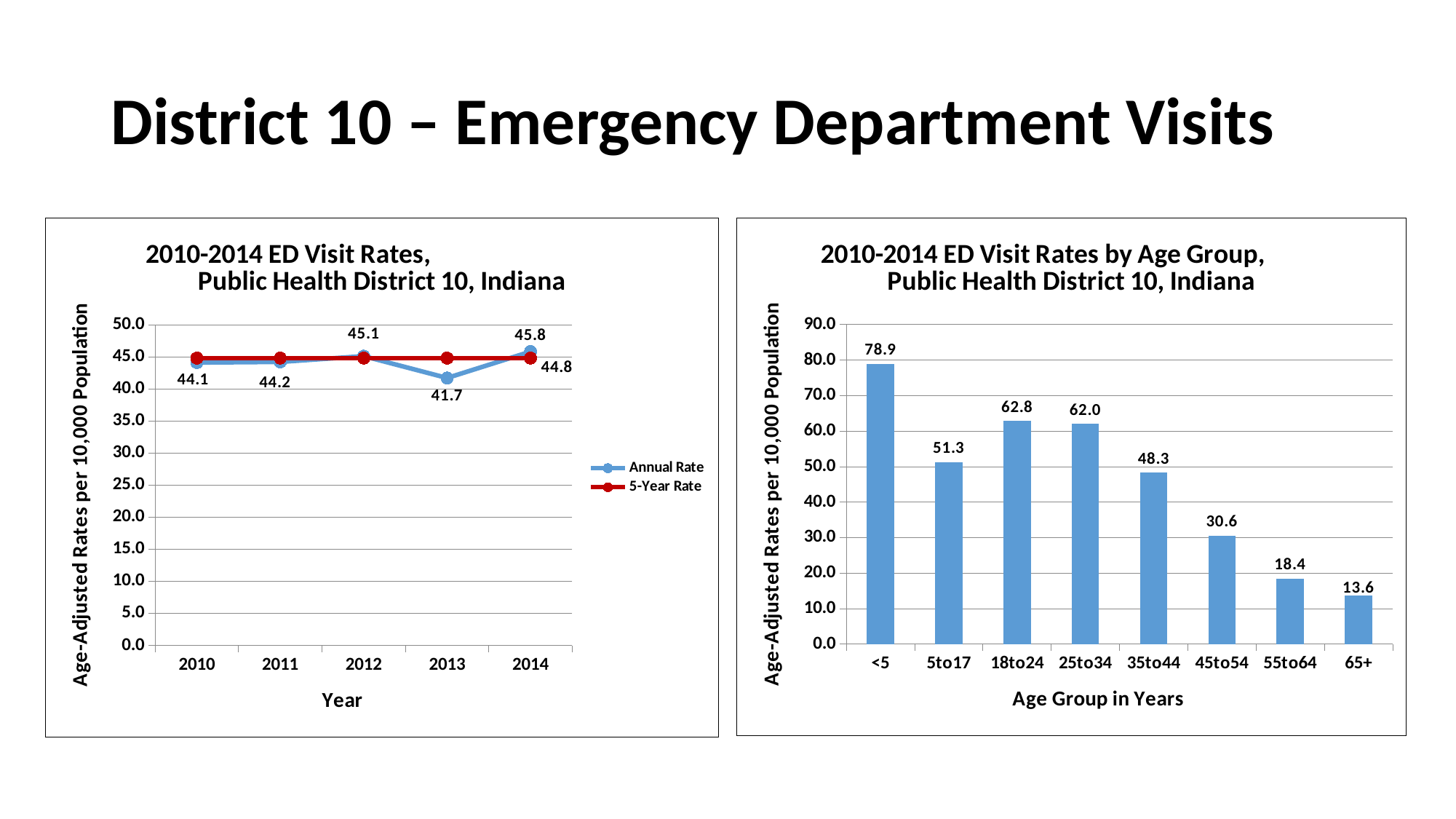
In the right chart (ED Visit Rates by Age Group), how many age groups are shown? 8 In the left chart (2010-2014 ED Visit Rates), what is the Annual Rate for 2013? 41.7 In the left chart (2010-2014 ED Visit Rates), what type of chart is shown? Line chart In the left chart (2010-2014 ED Visit Rates), which year has the highest Annual Rate? 2014 In the left chart (2010-2014 ED Visit Rates), what is the 5-Year Rate? 44.8 In the right chart (ED Visit Rates by Age Group), which is larger: the rate for 18to24 or for 25to34? 18to24 In the left chart (2010-2014 ED Visit Rates), which year has the lowest Annual Rate? 2013 In the right chart (ED Visit Rates by Age Group), what is the rate for the 35to44 age group? 48.3 In the left chart (2010-2014 ED Visit Rates), what is the difference between the Annual Rate in 2014 and in 2013? 4.1 In the right chart (ED Visit Rates by Age Group), which age group has the highest rate? <5 In the right chart (ED Visit Rates by Age Group), which age group has the lowest rate? 65+ In the left chart (2010-2014 ED Visit Rates), how many series does the legend list? 2